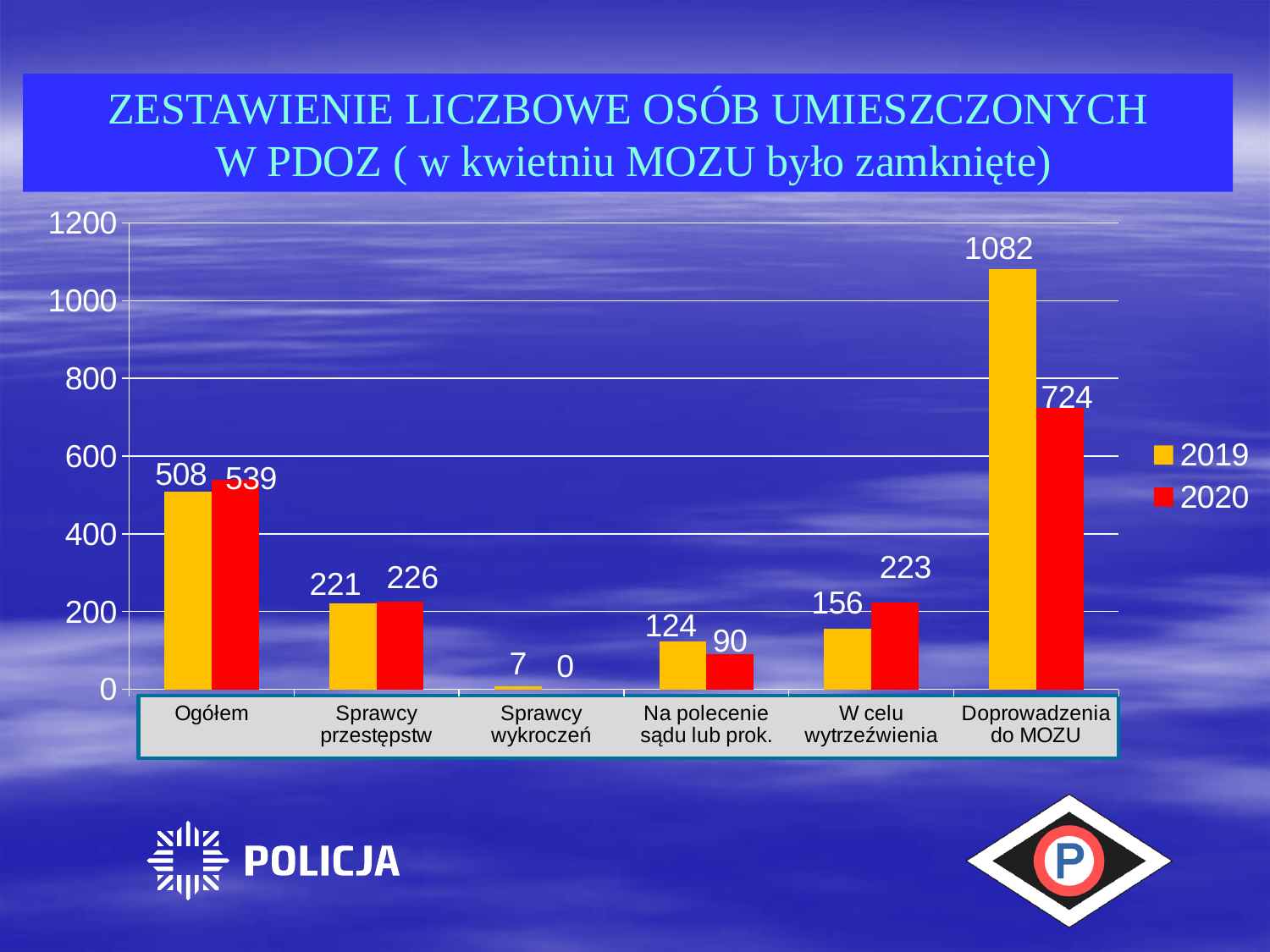
Is the 2019 value for Doprowadzenia do MOZU greater or less than 1000? greater What is the 2020 value for Doprowadzenia do MOZU? 724 Which category has the lowest 2020 value? Sprawcy wykroczeń Which category has the highest 2019 value? Doprowadzenia do MOZU What is the 2020 value for Sprawcy wykroczeń? 0 Which is larger for Na polecenie sądu lub prok., the 2019 value or the 2020 value? 2019 What is the difference between the 2020 and 2019 values for W celu wytrzeźwienia? 67 What kind of chart is shown on the slide? bar chart What is the difference between the 2019 and 2020 values for Doprowadzenia do MOZU? 358 How many categories are shown on the x axis? 6 What is the 2019 value for Ogółem? 508 How many series does the legend list? 2